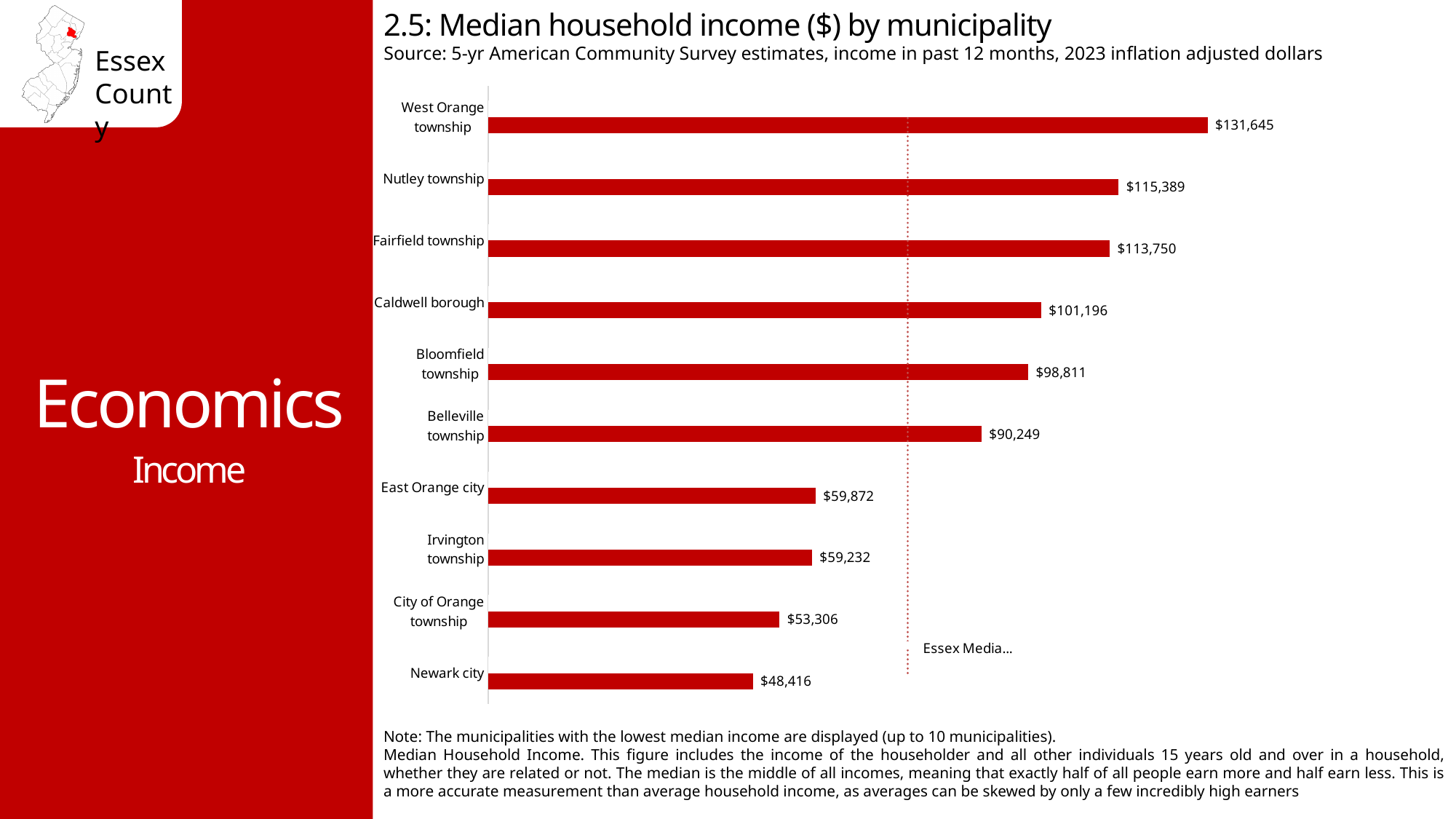
Which municipality has the highest median household income on the chart? West Orange township What is the difference between the median household income of West Orange township and Newark city? $83,229 Which municipality has the lowest median household income on the chart? Newark city What is the difference between the median household income of Nutley township and Fairfield township? $1,639 What is the median household income for Caldwell borough? $101,196 What is the median household income for West Orange township? $131,645 What type of chart is used to show median household income by municipality? Bar chart How many municipalities are shown on the chart? 10 Which has a higher median household income, Caldwell borough or Belleville township? Caldwell borough What is the median household income for Newark city? $48,416 What is the median household income for Irvington township? $59,232 What is the title of the chart? 2.5: Median household income ($) by municipality